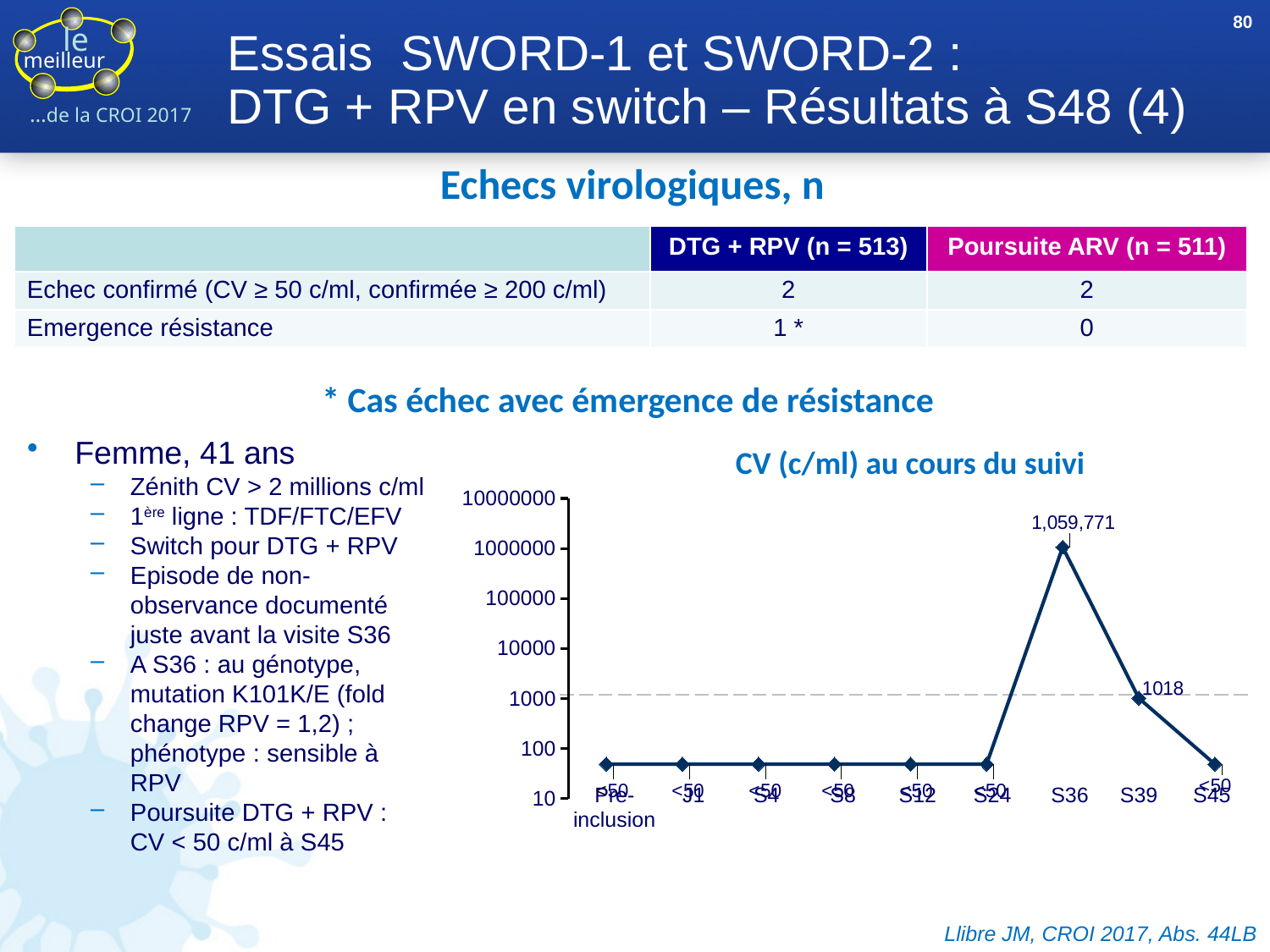
In the chart "CV (c/ml) au cours du suivi", what is the value labelled at S39? 1018 In the chart "CV (c/ml) au cours du suivi", what is the value labelled at S36? 1,059,771 In the chart "CV (c/ml) au cours du suivi", what is the value labelled at S24? <50 In the chart "CV (c/ml) au cours du suivi", how many time points are plotted on the x axis? 9 In the chart "CV (c/ml) au cours du suivi", which is larger, the value at S36 or the value at S39? S36 In the chart "CV (c/ml) au cours du suivi", what is the lowest tick value shown on the y axis? 10 In the chart "CV (c/ml) au cours du suivi", do the values rise or fall from S36 to S45? fall In the chart "CV (c/ml) au cours du suivi", what is the value labelled at S45? <50 In the chart "CV (c/ml) au cours du suivi", at which visit is the viral load highest? S36 What type of chart is shown under the title "CV (c/ml) au cours du suivi"? line chart In the chart "CV (c/ml) au cours du suivi", is the value at S39 greater or less than 1000? greater In the chart "CV (c/ml) au cours du suivi", is the value at S36 greater or less than 1000000? greater